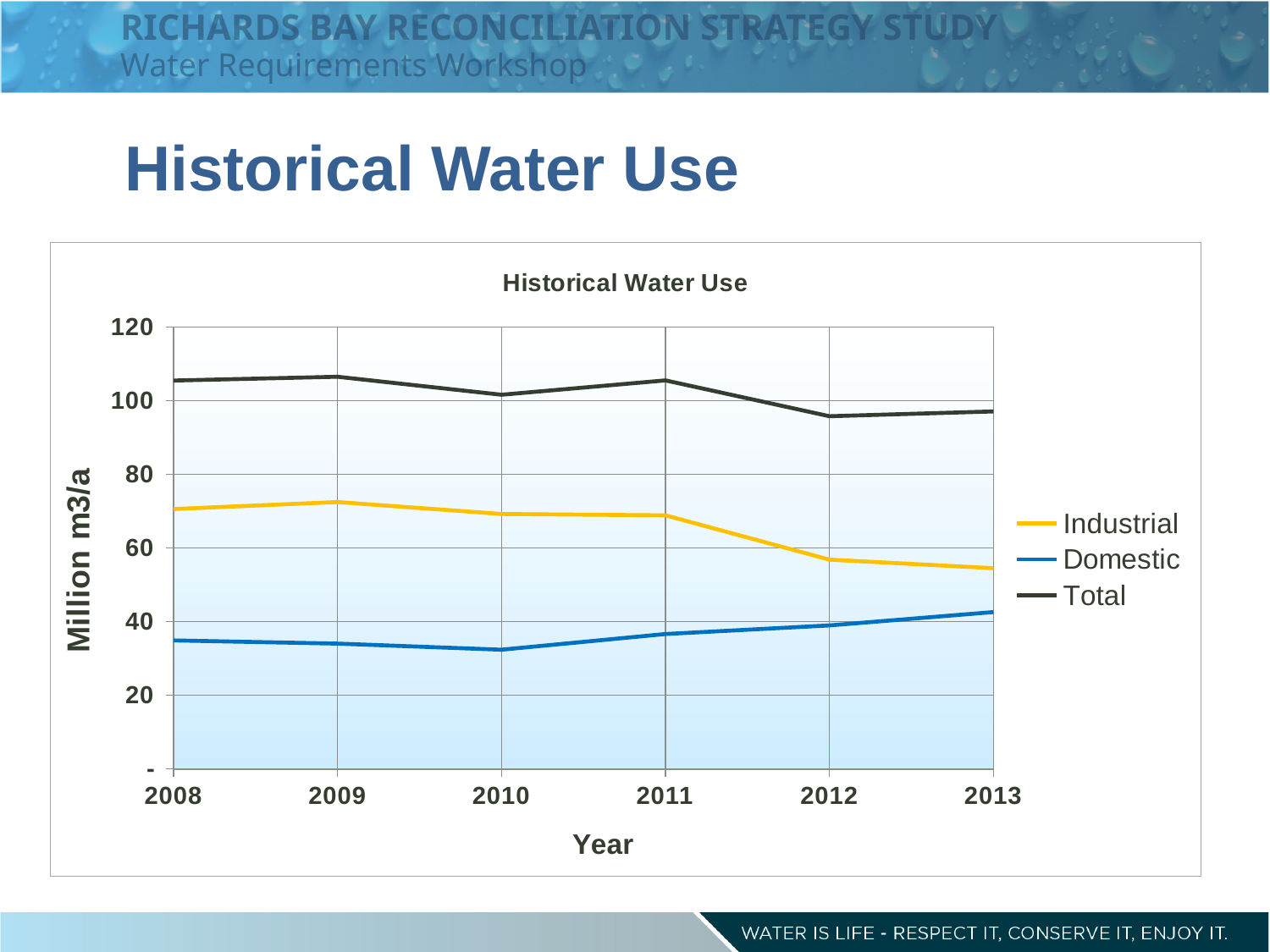
Is the Domestic value for 2010 greater or less than 40? less Does the Industrial series rise or fall from 2008 to 2013? fall In 2008, which is larger, the Industrial value or the Domestic value? Industrial What kind of chart is shown on the slide? line chart How many series does the legend list? 3 Is the Industrial value for 2013 greater or less than 60? less Does the Domestic series rise or fall from 2010 to 2013? rise Is the Total value for 2012 greater or less than 100? less How many years are plotted along the x axis? 6 What is the title of the chart? Historical Water Use What is the label of the y axis? Million m3/a In which year is the Domestic value highest? 2013